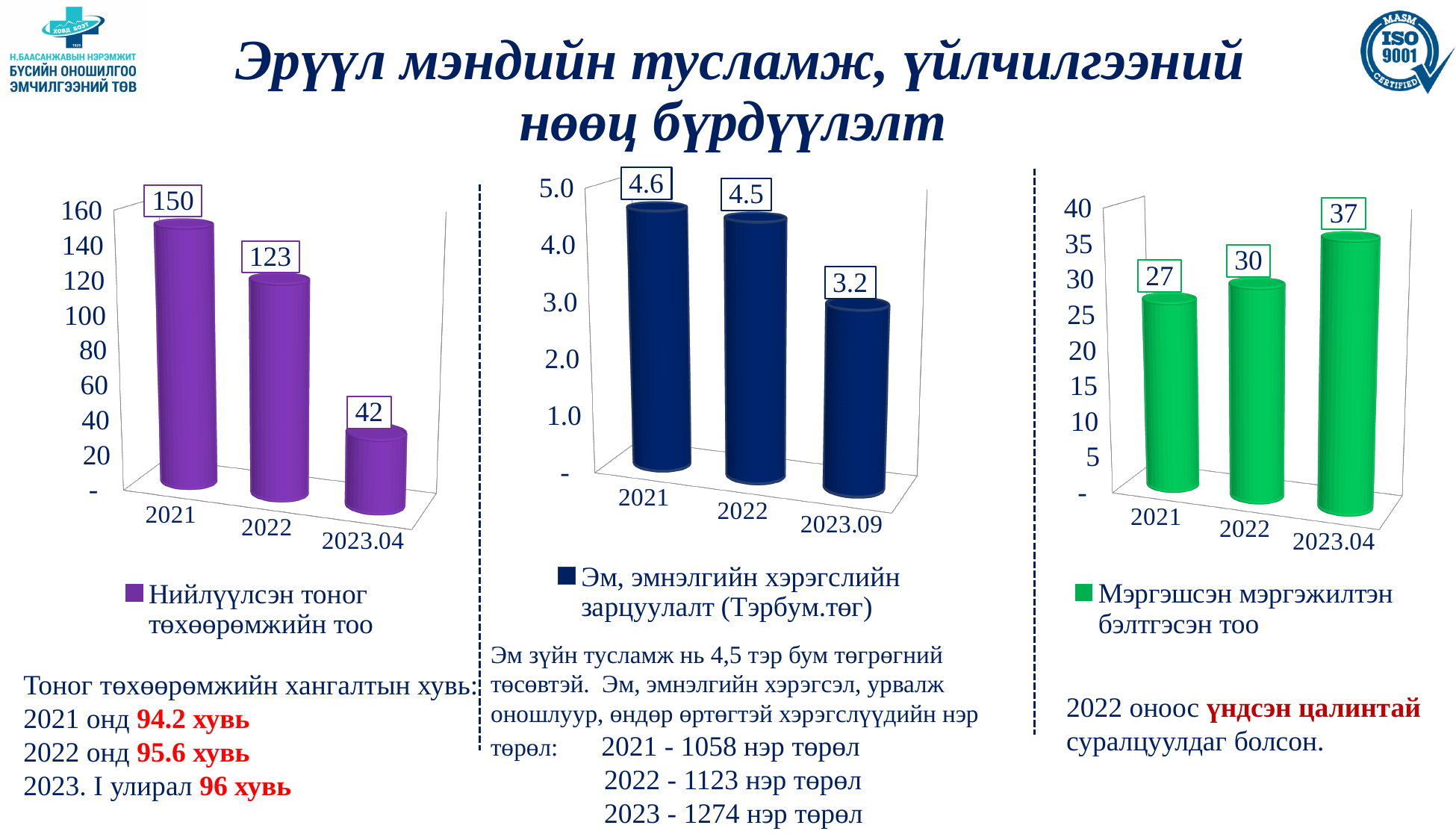
How many categories are shown on the x axis of the right chart (Мэргэшсэн мэргэжилтэн бэлтгэсэн тоо)? 3 In the left chart (Нийлүүлсэн тоног төхөөрөмжийн тоо), what is the value for 2023.04? 42 In the middle chart (Эм, эмнэлгийн хэрэгслийн зарцуулалт), what is the value for 2022? 4.5 In the right chart (Мэргэшсэн мэргэжилтэн бэлтгэсэн тоо), is the value for 2022 larger or smaller than the value for 2021? larger In the left chart (Нийлүүлсэн тоног төхөөрөмжийн тоо), what is the difference between the 2021 and 2022 values? 27 In the right chart (Мэргэшсэн мэргэжилтэн бэлтгэсэн тоо), which year has the highest value? 2023.04 In the middle chart (Эм, эмнэлгийн хэрэгслийн зарцуулалт), which year has the lowest value? 2023.09 In the left chart (Нийлүүлсэн тоног төхөөрөмжийн тоо), do the values rise or fall from 2021 to 2023.04? fall In the right chart (Мэргэшсэн мэргэжилтэн бэлтгэсэн тоо), what is the value for 2023.04? 37 In the middle chart (Эм, эмнэлгийн хэрэгслийн зарцуулалт), what is the difference between the 2021 and 2023.09 values? 1.4 In the left chart (Нийлүүлсэн тоног төхөөрөмжийн тоо), what is the value for 2021? 150 What kind of chart is the middle chart (Эм, эмнэлгийн хэрэгслийн зарцуулалт)? bar chart